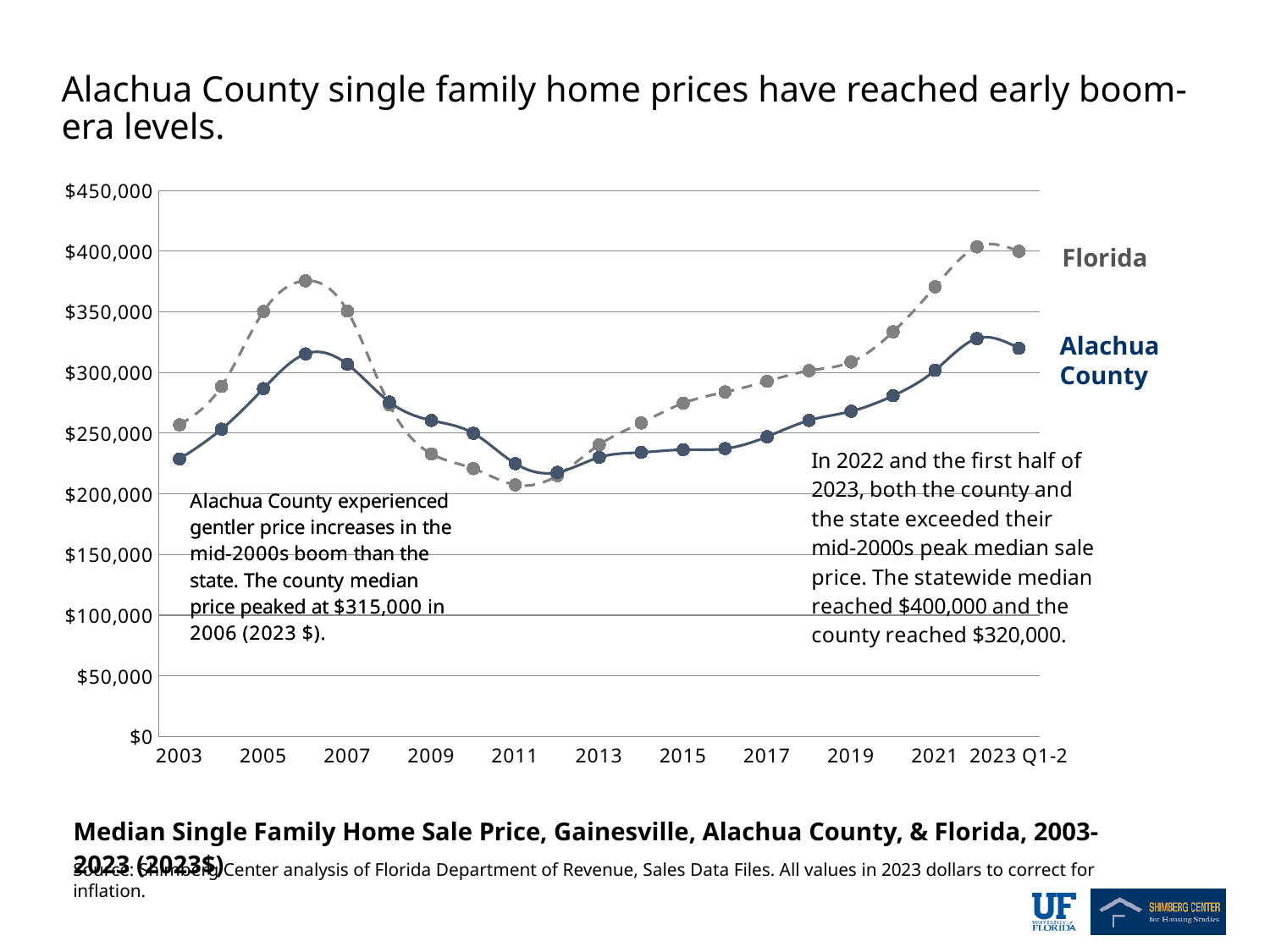
Is the Florida value for 2011 greater or less than $250,000? less Which series is drawn with a dashed gray line? Florida Do the Alachua County values rise or fall from 2012 to 2022? rise Is the Alachua County value for 2003 greater or less than $250,000? less In 2010, which series has the higher value, Florida or Alachua County? Alachua County What kind of chart is shown on the slide? line chart In which year does the Florida series reach its lowest value? 2011 How many series are plotted on the chart? 2 Is the Florida value for 2006 greater or less than $350,000? greater How many data points does each series have on the chart? 21 In 2006, which series has the higher value, Florida or Alachua County? Florida